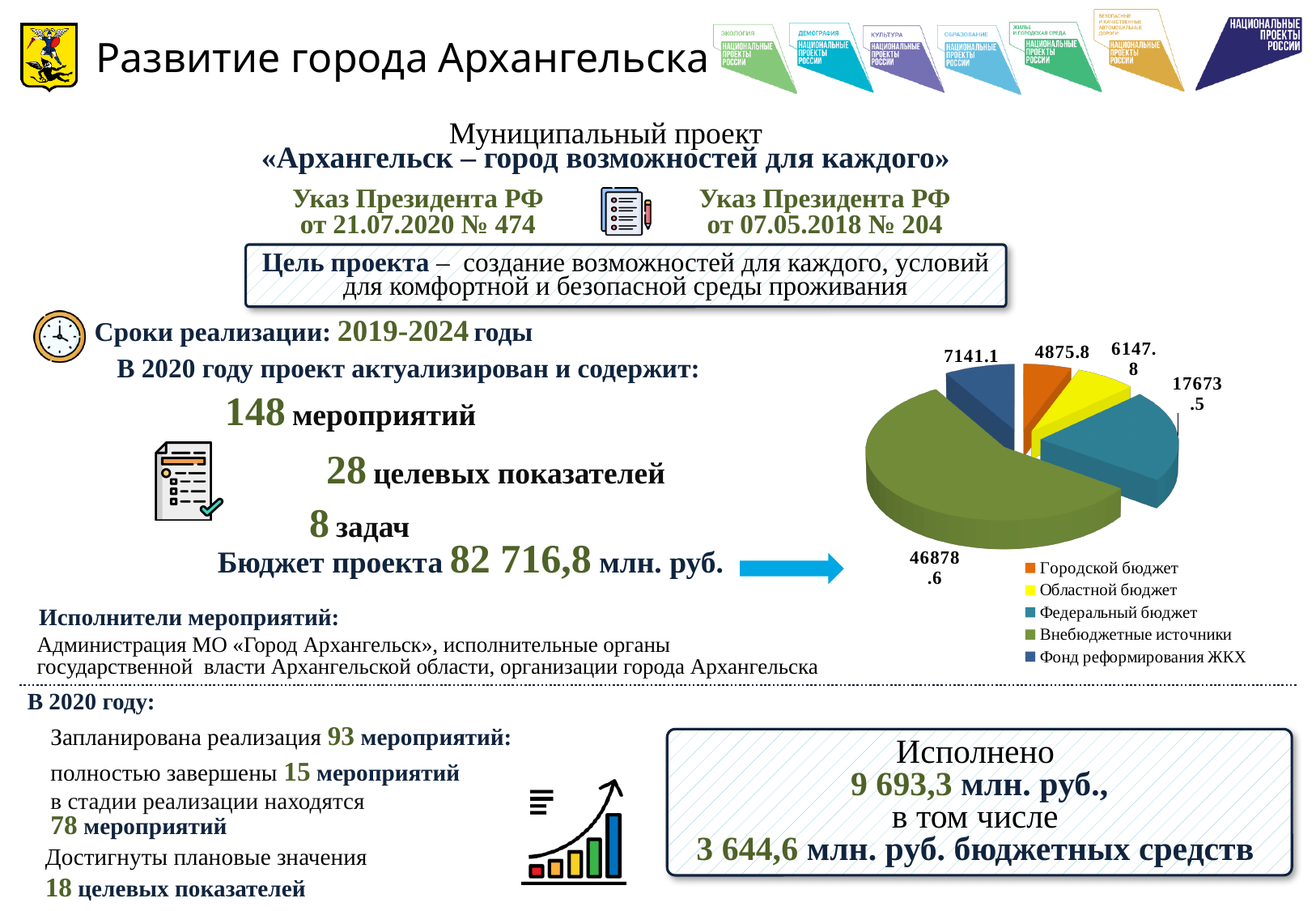
What is the value for Городской бюджет in the pie chart? 4875.8 Which colour represents Областной бюджет in the pie chart? yellow What is the value for Внебюджетные источники in the pie chart? 46878.6 What is the value for Фонд реформирования ЖКХ in the pie chart? 7141.1 How many entries does the legend of the pie chart list? 5 What is the difference between the values for Федеральный бюджет and Областной бюджет? 11525.7 Which category has the smallest slice in the pie chart? Городской бюджет What is the value for Федеральный бюджет in the pie chart? 17673.5 What kind of chart is shown on the slide? pie chart How many categories does the pie chart show? 5 Which category has the largest slice in the pie chart? Внебюджетные источники Which is larger in the pie chart: Фонд реформирования ЖКХ or Областной бюджет? Фонд реформирования ЖКХ